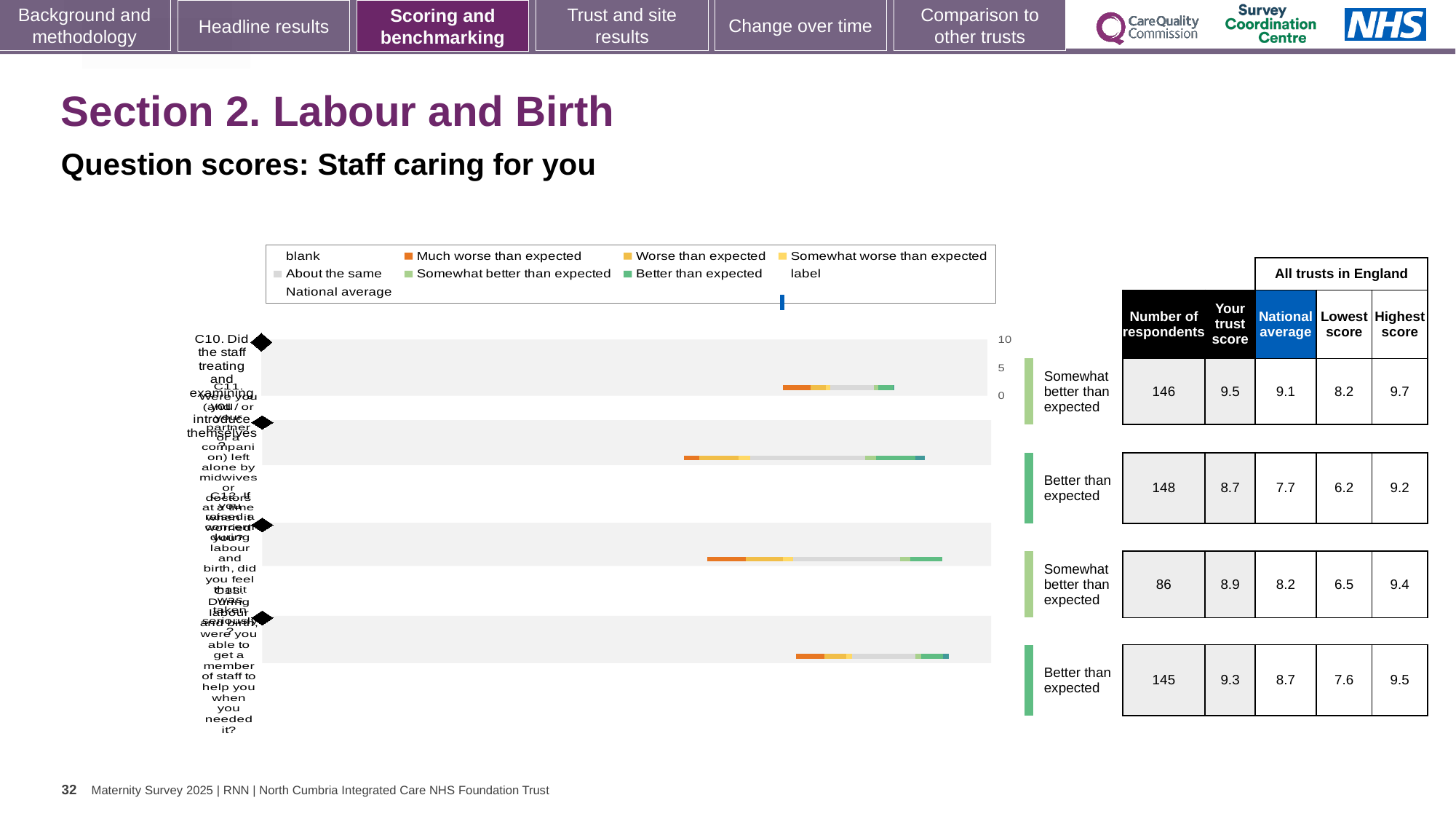
What is the subtitle of the chart section on the slide? Question scores: Staff caring for you Which row has the highest 'Your trust score'? C10 (first row), 9.5 Is the trust score for the second row (C11) higher or lower than its national average? higher What is the 'Your trust score' for the first row (C10, staff introducing themselves)? 9.5 What benchmark category is shown for the second row (C11)? Better than expected How many survey questions (rows) are plotted in the chart? 4 What is the difference between the trust score and the national average for the first row (C10)? 0.4 What is the national average for the second row (C11, left alone by midwives or doctors)? 7.7 How many respondents answered the third row question (C12, concern taken seriously)? 86 Which row has the lowest number of respondents? C12 (third row), 86 What kind of chart is shown on the slide? bar chart What is the highest score among all trusts in England for the fourth row (C13, getting a member of staff to help)? 9.5